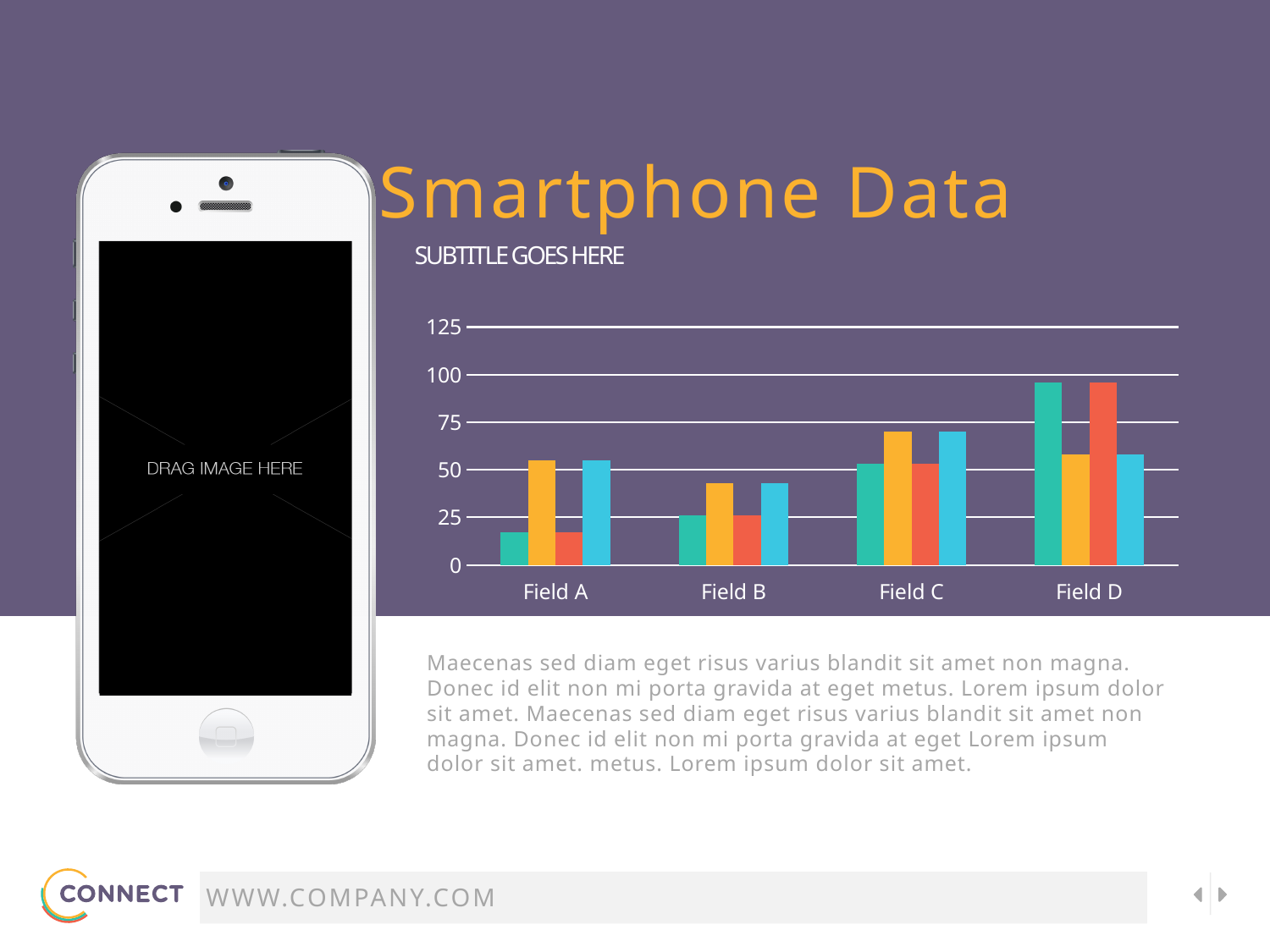
How many bars are plotted for each category in the chart? 4 Is the value of the green bar for Field D greater or less than 75? greater How many categories are shown on the x axis of the chart? 4 Within Field A, which is larger: the green bar or the yellow bar? the yellow bar What kind of chart is shown on the slide? bar chart Do the green bars rise or fall from Field A to Field D? rise Is the value of the yellow bar for Field C greater or less than 50? greater Is the value of the green bar for Field A greater or less than 25? less Which category has the shortest yellow bar? Field B Which category has the tallest green bar? Field D